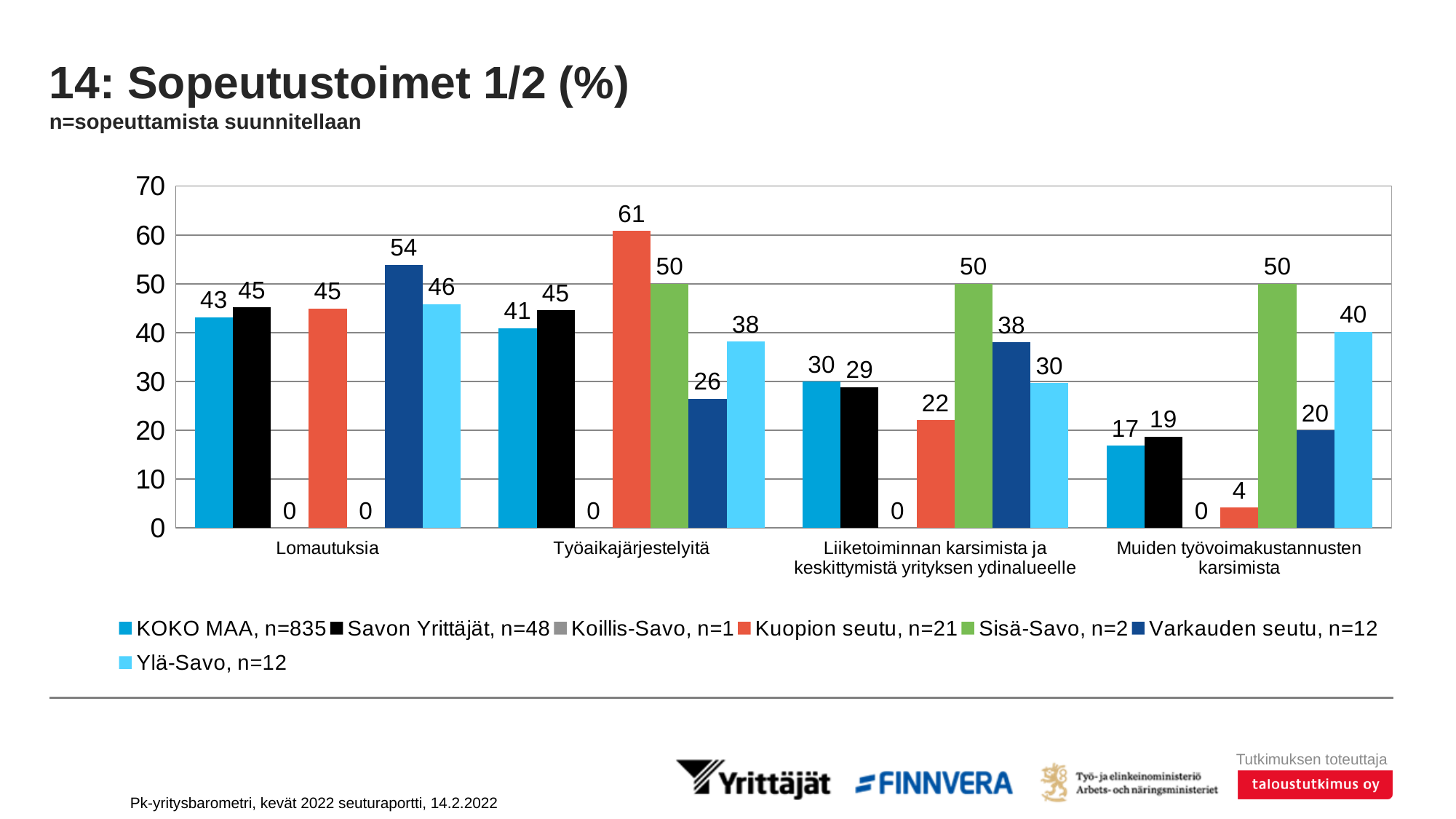
What is the value for Varkauden seutu in the Liiketoiminnan karsimista ja keskittymistä yrityksen ydinalueelle category? 38 Which category has the lowest value for KOKO MAA? Muiden työvoimakustannusten karsimista What is the value for KOKO MAA in the Lomautuksia category? 43 In the Muiden työvoimakustannusten karsimista category, which is larger: Savon Yrittäjät or Kuopion seutu? Savon Yrittäjät What is the value for Kuopion seutu in the Työaikajärjestelyitä category? 61 Which series has the highest value in the Lomautuksia category? Varkauden seutu, n=12 How many series does the legend list? 7 What kind of chart is shown on the slide? Bar chart How many categories are shown on the x axis? 4 What is the value for Ylä-Savo in the Muiden työvoimakustannusten karsimista category? 40 What is the sample size (n) shown in the legend for Savon Yrittäjät? 48 What is the difference between the Kuopion seutu and Sisä-Savo values in the Työaikajärjestelyitä category? 11